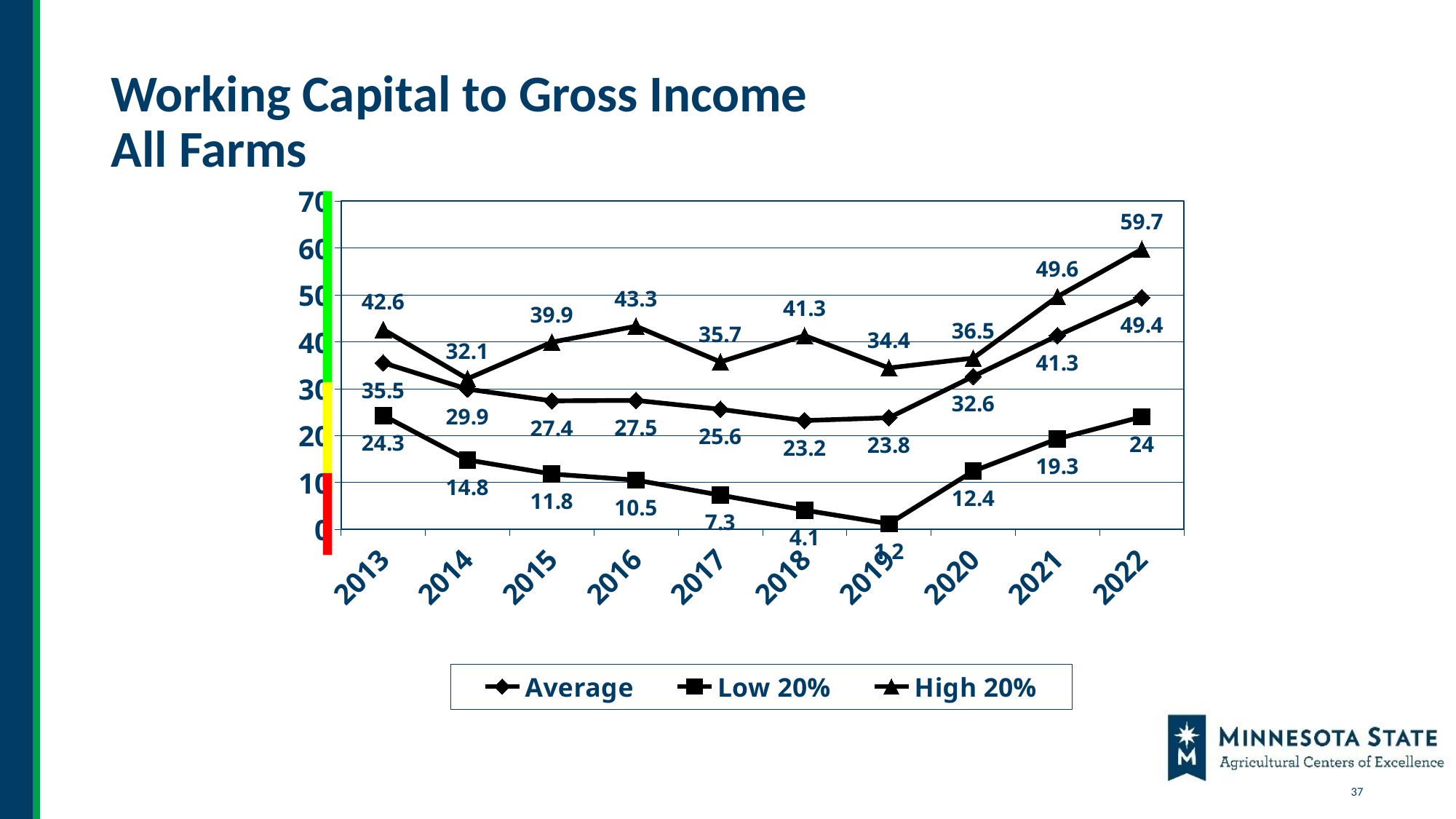
In which year is the High 20% series at its highest? 2022 What is the High 20% value for 2022? 59.7 Which year has the larger Average value, 2013 or 2014? 2013 What is the difference between the High 20% and Average values in 2022? 10.3 What kind of chart is shown on the slide? line chart How many series does the legend list? 3 In which year is the Average series at its lowest? 2018 How many years are shown on the x axis? 10 Does the Low 20% series rise or fall from 2013 to 2018? fall Is the Average value for 2021 greater or less than 40? greater What is the Average value for 2018? 23.2 What is the Low 20% value for 2017? 7.3